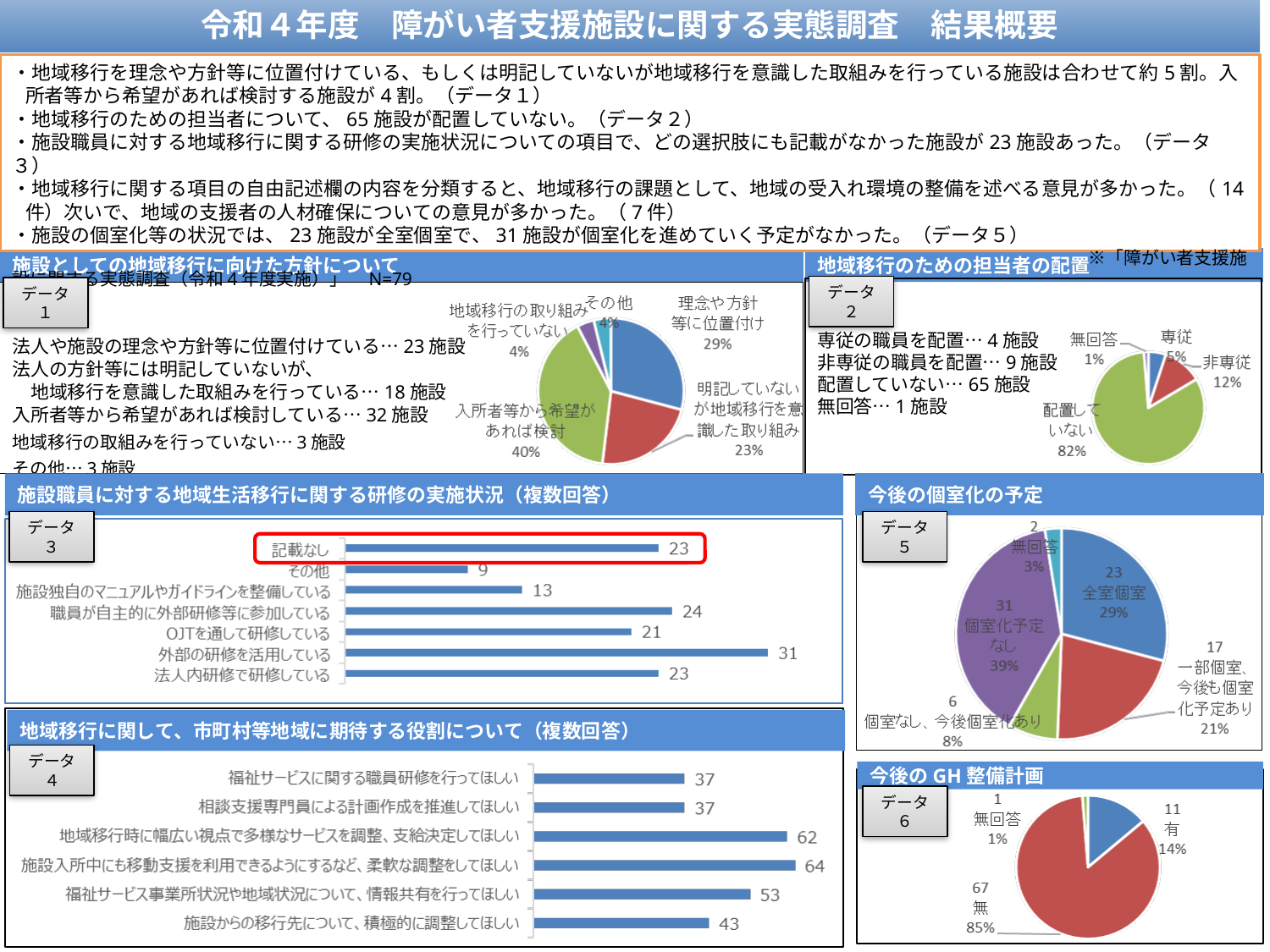
In the chart titled 「施設職員に対する地域生活移行に関する研修の実施状況（複数回答）」, what is the value for 「外部の研修を活用している」? 31 In the chart titled 「地域移行に関して、市町村等地域に期待する役割について（複数回答）」, which category has the highest value? 施設入所中にも移動支援を利用できるようにするなど、柔軟な調整をしてほしい In the chart titled 「地域移行に関して、市町村等地域に期待する役割について（複数回答）」, what is the difference between the values for 「地域移行時に幅広い視点で多様なサービスを調整、支給決定してほしい」 and 「施設からの移行先について、積極的に調整してほしい」? 19 In the chart titled 「施設職員に対する地域生活移行に関する研修の実施状況（複数回答）」, how many categories are plotted? 7 In the pie chart titled 「今後のGH整備計画」, what share does 「無」 have? 85% In the pie chart titled 「地域移行のための担当者の配置」, what share does 「配置していない」 have? 82% In the pie chart titled 「今後の個室化の予定」, what is the value for 「個室化予定なし」? 31 In the pie chart titled 「今後の個室化の予定」, how many slices are there? 5 In the pie chart titled 「施設としての地域移行に向けた方針について」, what share does 「入所者等から希望があれば検討」 have? 40% In the pie chart titled 「地域移行のための担当者の配置」, which is larger, 「専従」 or 「非専従」? 非専従 In the chart titled 「施設職員に対する地域生活移行に関する研修の実施状況（複数回答）」, which category has the lowest value? その他 What kind of chart is the one titled 「地域移行に関して、市町村等地域に期待する役割について（複数回答）」? bar chart